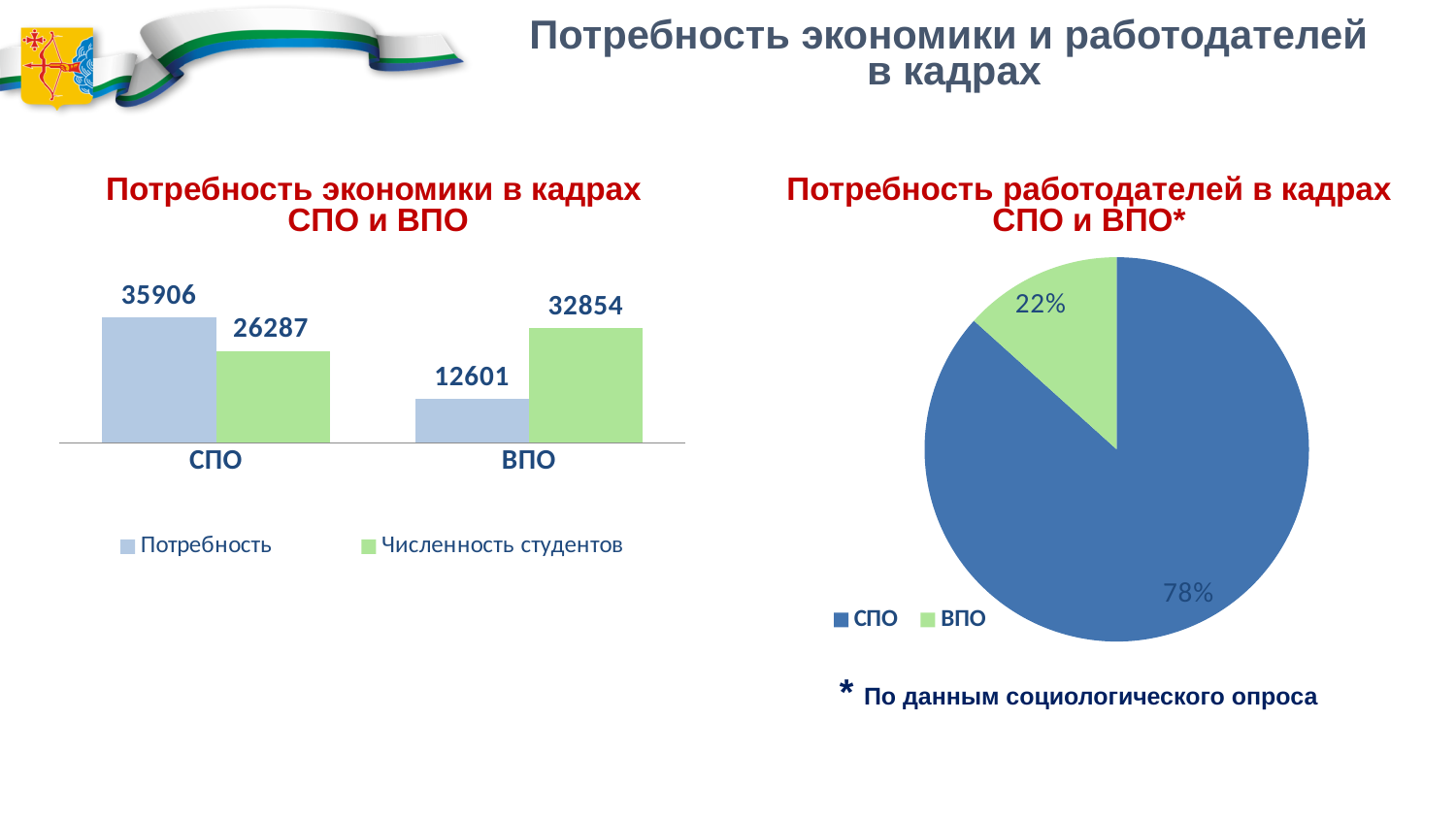
In the bar chart 'Потребность экономики в кадрах СПО и ВПО', what is the value of Потребность for СПО? 35906 In the pie chart 'Потребность работодателей в кадрах СПО и ВПО*', what share does ВПО have? 22% In the bar chart 'Потребность экономики в кадрах СПО и ВПО', what is the value of Потребность for ВПО? 12601 In the bar chart 'Потребность экономики в кадрах СПО и ВПО', what is the value of Численность студентов for СПО? 26287 In the pie chart 'Потребность работодателей в кадрах СПО и ВПО*', what share does СПО have? 78% In the bar chart 'Потребность экономики в кадрах СПО и ВПО', what is the difference between Потребность and Численность студентов for СПО? 9619 In the bar chart 'Потребность экономики в кадрах СПО и ВПО', which is larger for ВПО: Потребность or Численность студентов? Численность студентов How many series does the legend of the bar chart 'Потребность экономики в кадрах СПО и ВПО' list? 2 In the bar chart 'Потребность экономики в кадрах СПО и ВПО', what is the value of Численность студентов for ВПО? 32854 What kind of chart is 'Потребность работодателей в кадрах СПО и ВПО*'? pie chart What kind of chart is 'Потребность экономики в кадрах СПО и ВПО'? bar chart In the bar chart 'Потребность экономики в кадрах СПО и ВПО', which category has the highest Потребность value? СПО